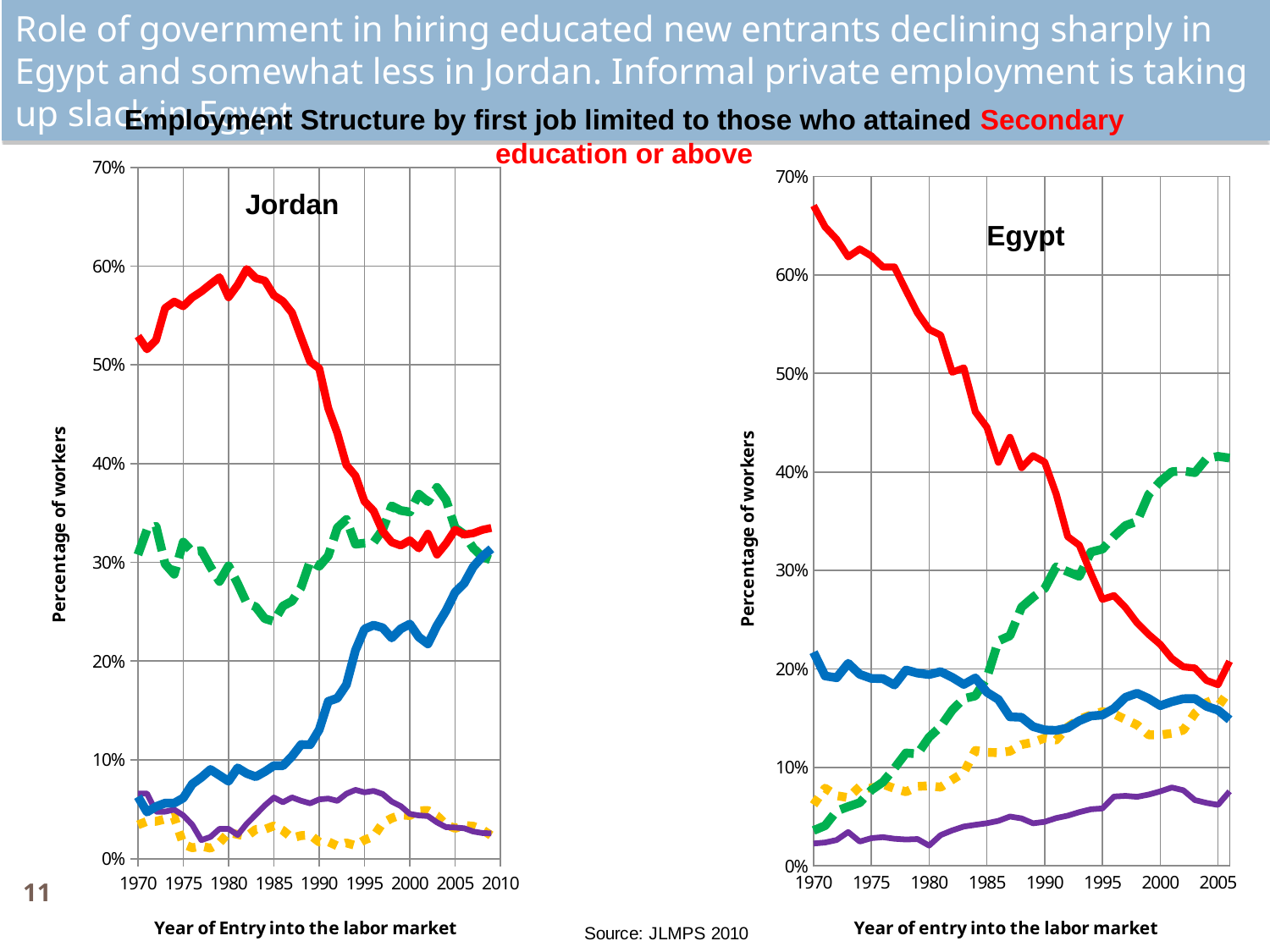
In the Egypt chart, at 2005, is the green dashed line or the red line higher? the green dashed line In the Egypt chart, does the green dashed line rise or fall from 1970 to 2005? rise In the Egypt chart, is the value of the green dashed line at 2005 greater or less than 30%? greater In the Egypt chart, does the red line rise or fall from 1970 to 2005? fall In the Jordan chart, is the value of the blue line at 2010 greater or less than 20%? greater What kind of chart is the Egypt chart? line chart In the Jordan chart, is the value of the red line at 1980 greater or less than 50%? greater In the Egypt chart, which line is highest at 1970? the red line In the Jordan chart, does the blue line rise or fall from 1970 to 2010? rise What kind of chart is the Jordan chart? line chart What is the y-axis label on the Jordan chart? Percentage of workers